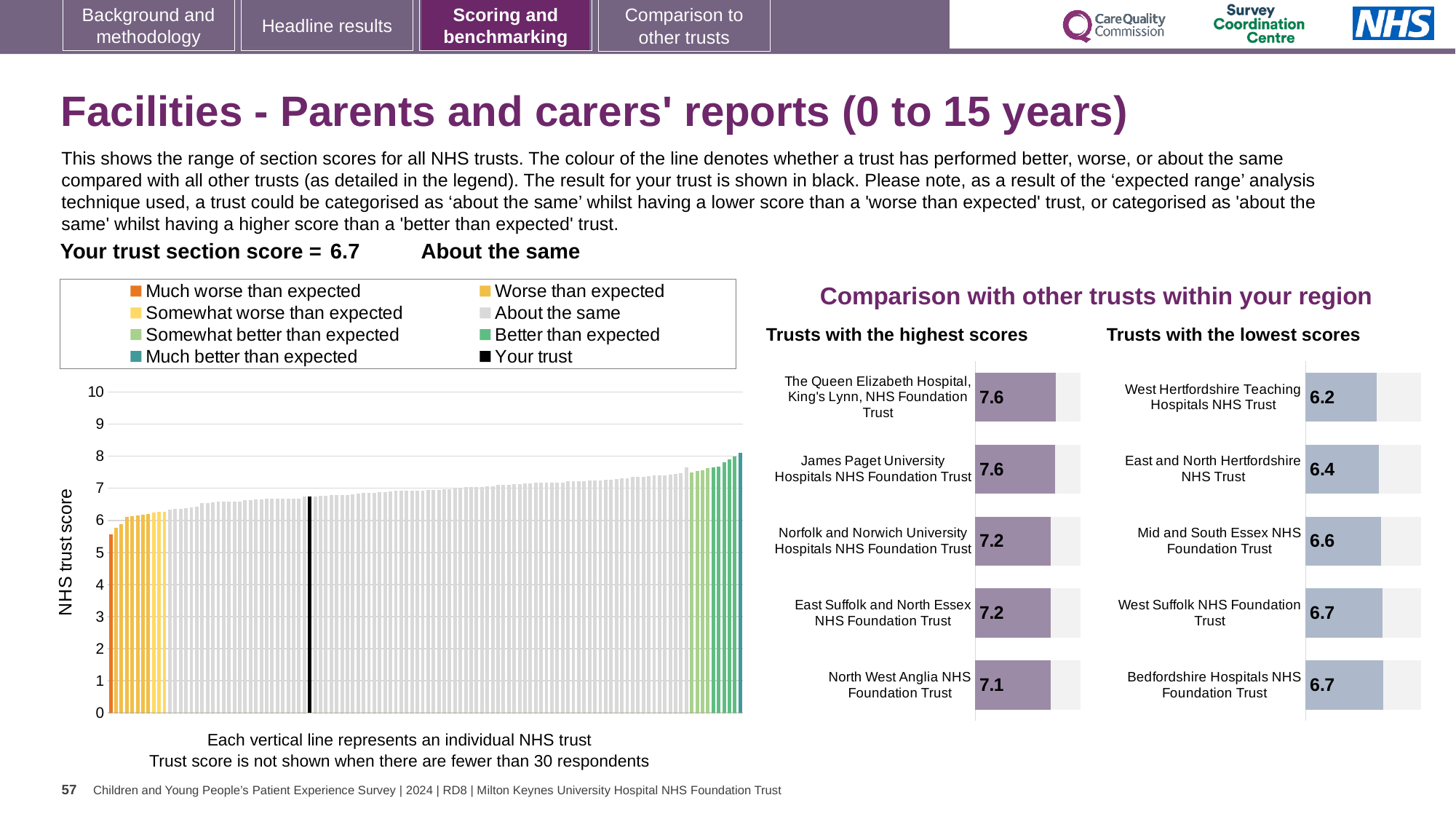
Which has the higher score: Norfolk and Norwich University Hospitals NHS Foundation Trust in the highest scores chart, or Mid and South Essex NHS Foundation Trust in the lowest scores chart? Norfolk and Norwich University Hospitals NHS Foundation Trust In the 'Trusts with the highest scores' chart, which trust has the lowest score? North West Anglia NHS Foundation Trust What kind of chart is the main chart showing NHS trust scores on the left of the slide? Bar chart In the 'Trusts with the lowest scores' chart, what is the score for West Hertfordshire Teaching Hospitals NHS Trust? 6.2 How many entries does the legend of the main NHS trust score chart list? 8 In the 'Trusts with the lowest scores' chart, what is the score for Mid and South Essex NHS Foundation Trust? 6.6 In the 'Trusts with the highest scores' chart, what is the difference between the scores of The Queen Elizabeth Hospital, King's Lynn and North West Anglia NHS Foundation Trust? 0.5 In the 'Trusts with the highest scores' chart, what is the score for The Queen Elizabeth Hospital, King's Lynn, NHS Foundation Trust? 7.6 In the 'Trusts with the lowest scores' chart, which trust has the lowest score? West Hertfordshire Teaching Hospitals NHS Trust In the main NHS trust score chart, do the values rise or fall from left to right? Rise In the 'Trusts with the highest scores' chart, what is the score for North West Anglia NHS Foundation Trust? 7.1 How many trusts are shown in the 'Trusts with the lowest scores' chart? 5